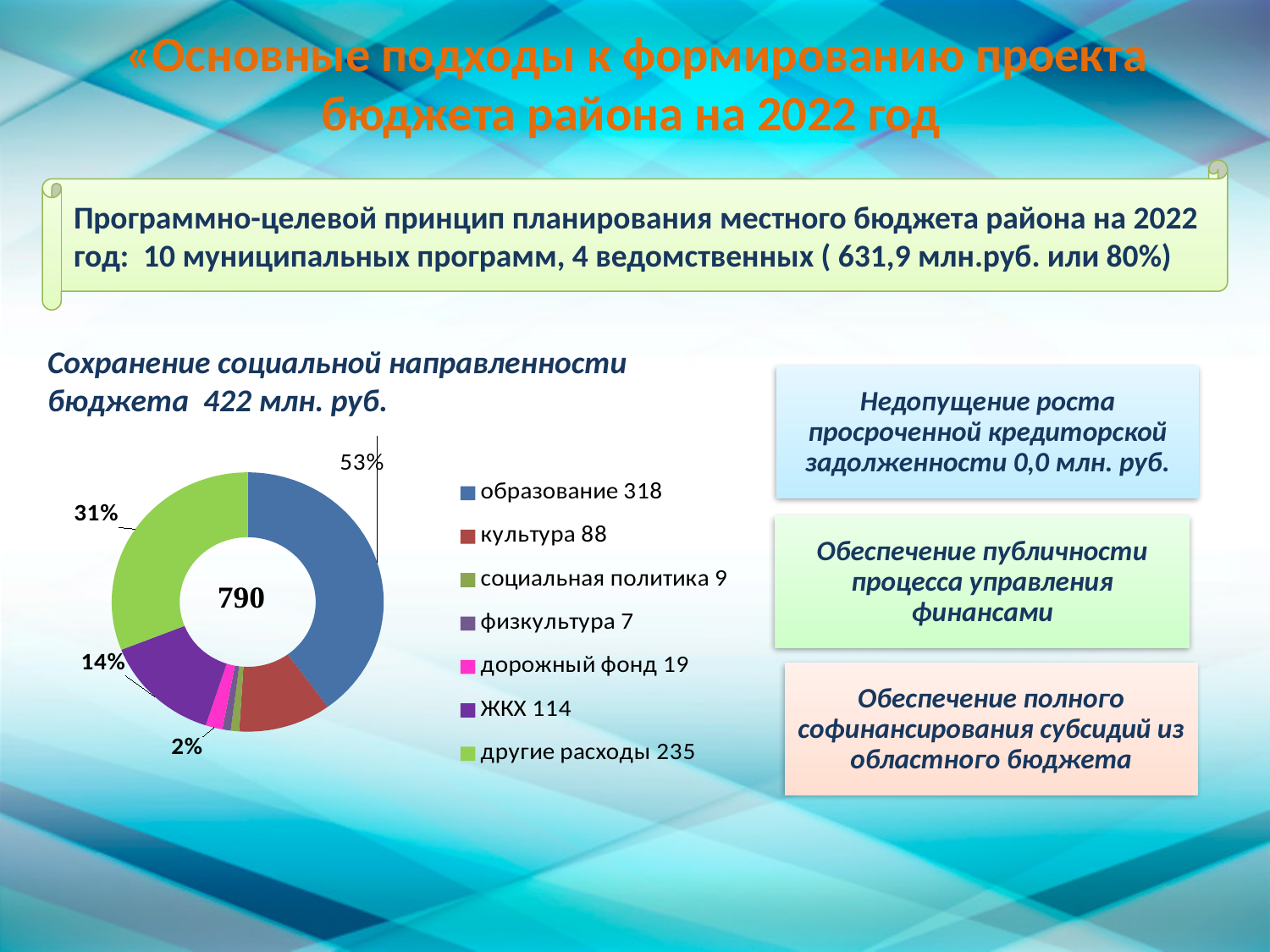
What value is listed for ЖКХ in the chart legend? 114 Which is larger, the value for ЖКХ or the value for культура? ЖКХ What number is printed in the centre of the doughnut chart? 790 Which category has the largest value in the chart? образование How many categories does the chart legend list? 7 What value is listed for образование in the chart legend? 318 What value is listed for культура in the chart legend? 88 What is the difference between the values for образование and другие расходы? 83 What kind of chart is shown on the slide? pie chart (doughnut) What value is listed for дорожный фонд in the chart legend? 19 Which category has the smallest value in the chart? физкультура What is the difference between the values for ЖКХ and дорожный фонд? 95